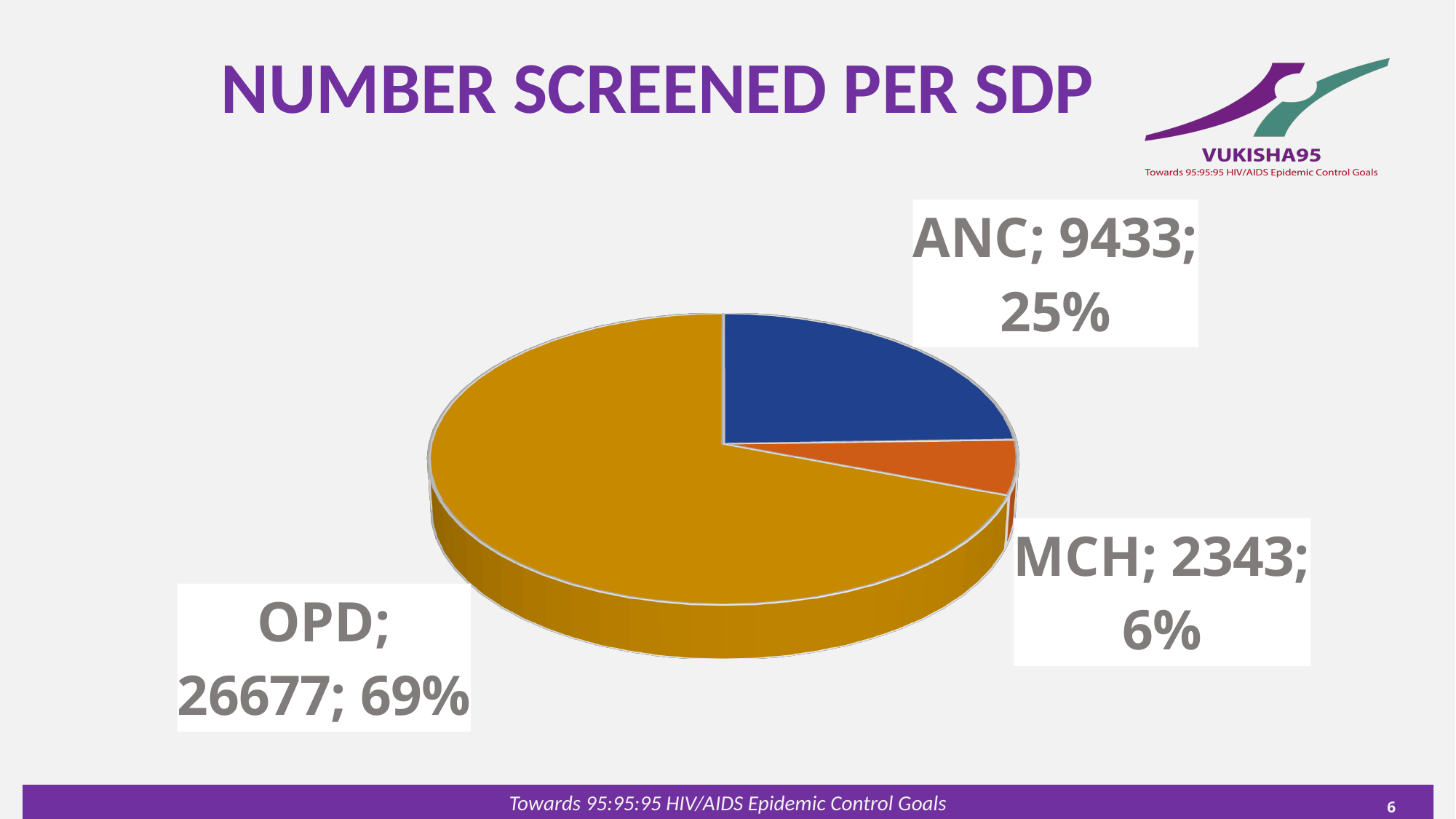
Which SDP has the highest number screened? OPD What share of the pie does OPD represent? 69% Which SDP has the lowest number screened? MCH How many slices does the pie chart have? 3 Which has a larger number screened, ANC or MCH? ANC What is the number screened for OPD? 26677 What is the number screened for ANC? 9433 What share of the pie does MCH represent? 6% What is the difference between the number screened for OPD and ANC? 17244 What share of the pie does ANC represent? 25% What type of chart is shown on the slide? pie chart What is the number screened for MCH? 2343